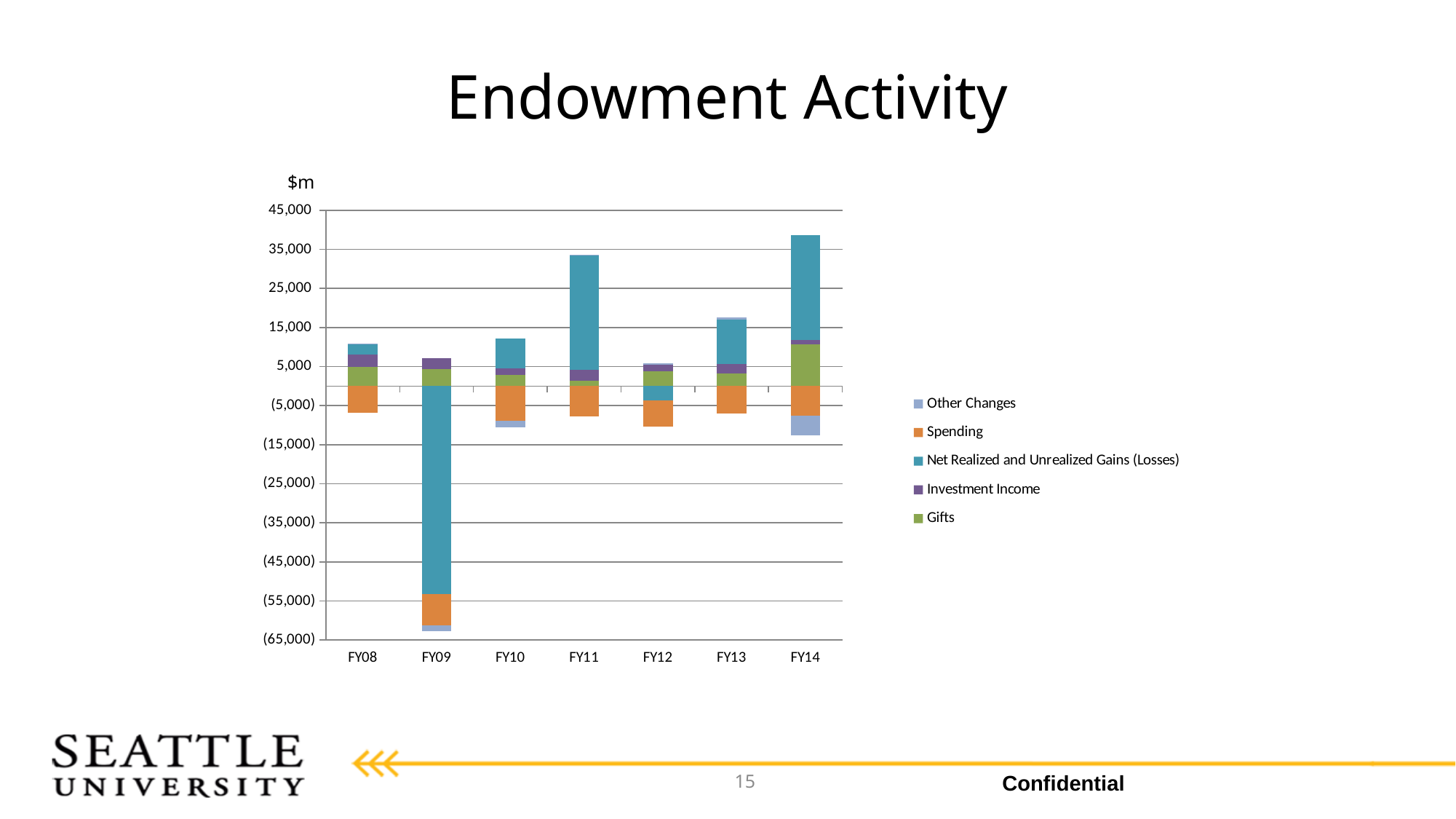
How many series does the chart's legend list? 5 Which year has the larger Gifts segment, FY14 or FY08? FY14 Which fiscal year has the tallest positive stacked bar? FY14 Is the Net Realized and Unrealized Gains (Losses) value for FY09 greater or less than (45,000)? less Which fiscal year has the largest negative Net Realized and Unrealized Gains (Losses) segment? FY09 Is the top of the stacked bar for FY10 greater or less than 15,000? less What kind of chart is shown on the slide? Stacked bar chart Is the top of the stacked bar for FY14 greater or less than 35,000? greater What unit label is shown above the vertical axis of the chart? $m How many fiscal years are shown on the x axis of the chart? 7 What is the title of the chart on the slide? Endowment Activity